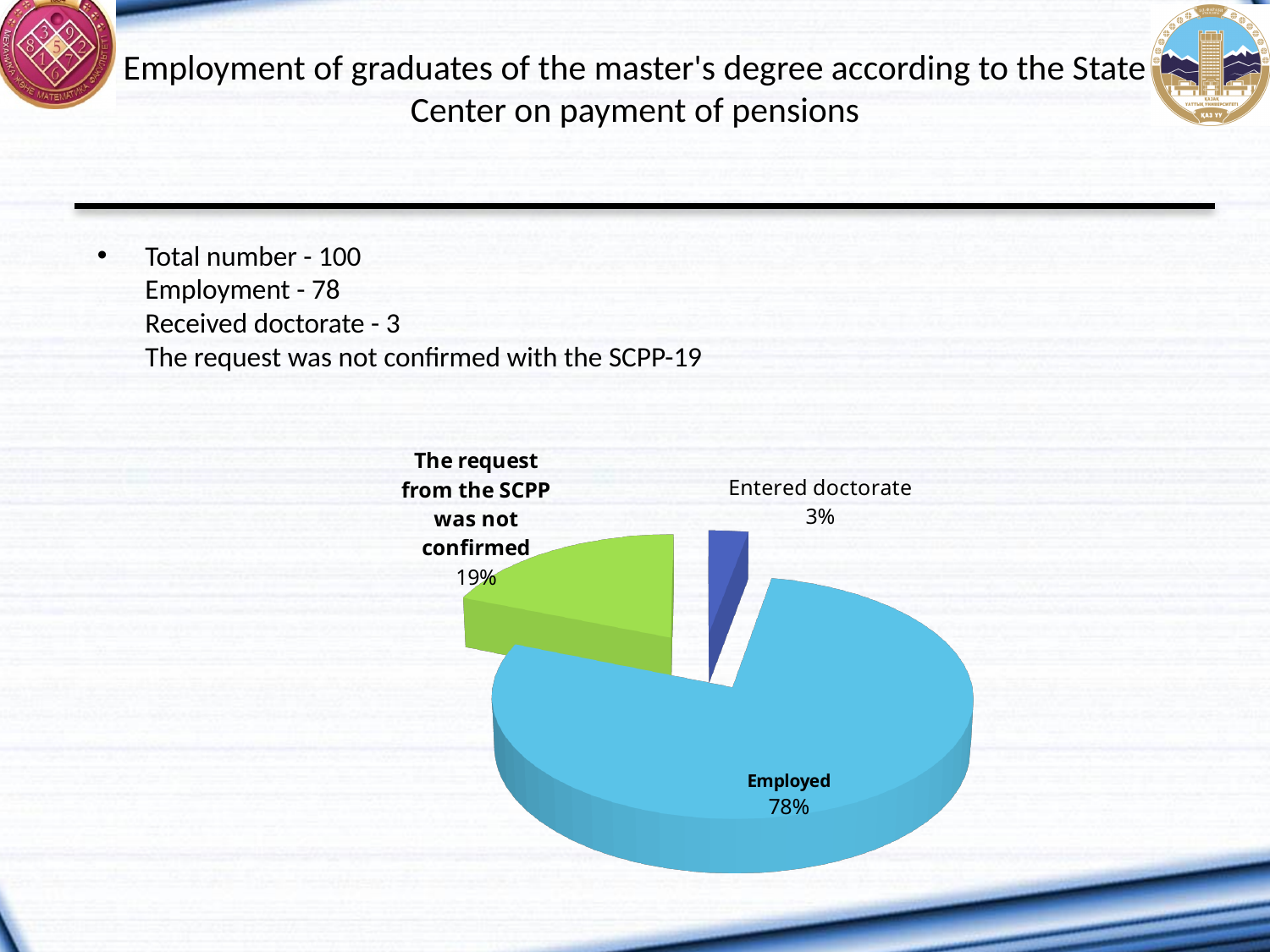
Which category has the smallest share of the pie? Entered doctorate What percentage of graduates are shown as Employed? 78% What is the difference in percentage points between Employed and 'The request from the SCPP was not confirmed'? 59 Which is larger: the share for Entered doctorate or the share for 'The request from the SCPP was not confirmed'? The request from the SCPP was not confirmed What colour is the slice for 'The request from the SCPP was not confirmed'? green What is the difference in percentage points between 'The request from the SCPP was not confirmed' and Entered doctorate? 16 What kind of chart is shown on the slide? pie chart Which category has the largest share of the pie? Employed What percentage is shown for 'The request from the SCPP was not confirmed'? 19% What percentage of graduates Entered doctorate? 3% How many slices does the pie chart have? 3 What colour is the Employed slice of the pie? light blue